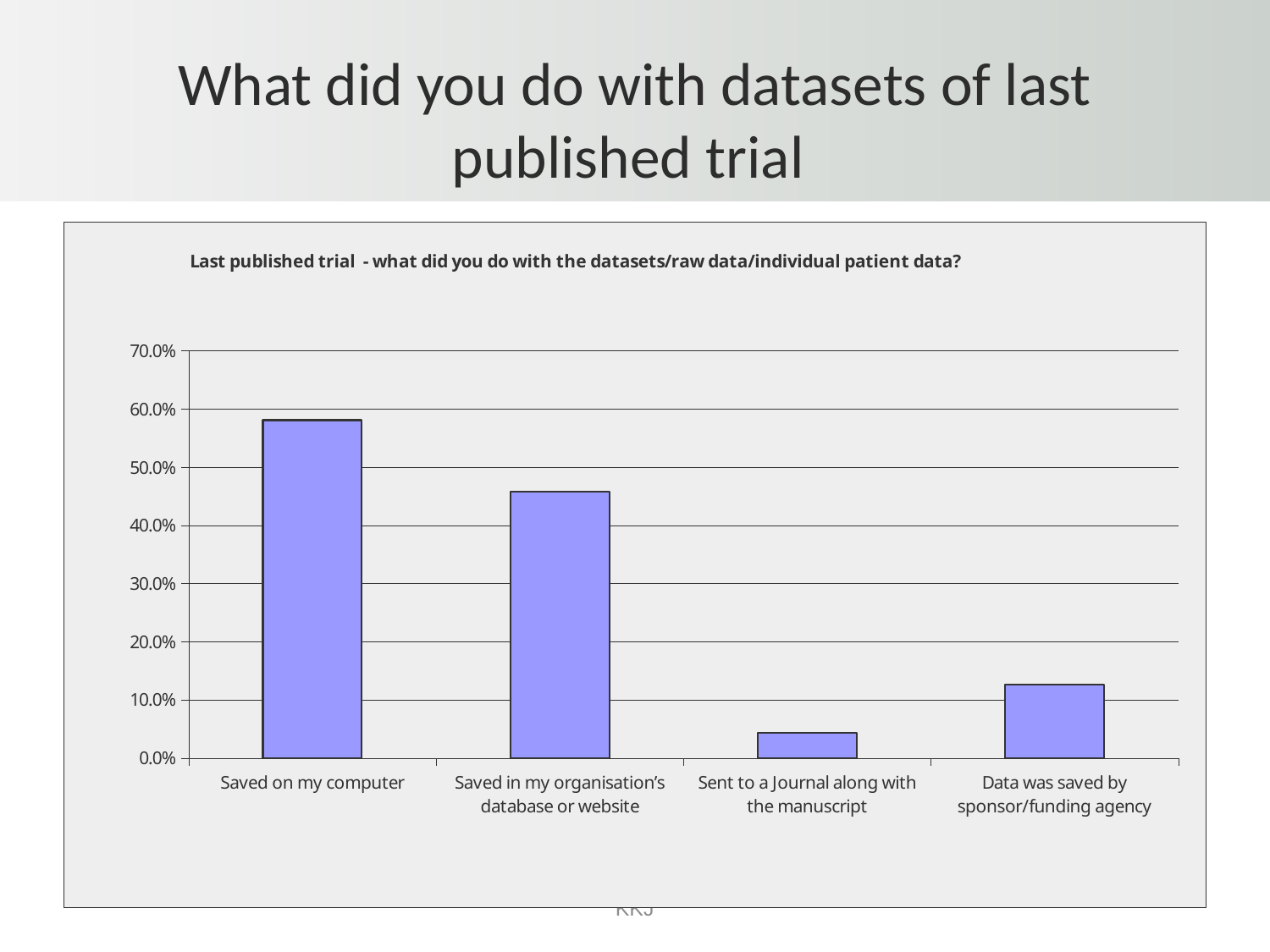
Which category has the highest value in the chart? Saved on my computer What kind of chart is shown on the slide? bar chart Which is larger: the value for 'Data was saved by sponsor/funding agency' or the value for 'Sent to a Journal along with the manuscript'? Data was saved by sponsor/funding agency Is the value for 'Sent to a Journal along with the manuscript' greater or less than 10%? less Which category has the lowest value in the chart? Sent to a Journal along with the manuscript How many categories are shown on the x axis of the chart? 4 Is the value for 'Saved on my computer' greater or less than 50%? greater Is the value for 'Saved in my organisation's database or website' greater or less than 40%? greater What is the title of the chart? Last published trial - what did you do with the datasets/raw data/individual patient data? Which is larger: the value for 'Saved on my computer' or the value for 'Saved in my organisation's database or website'? Saved on my computer